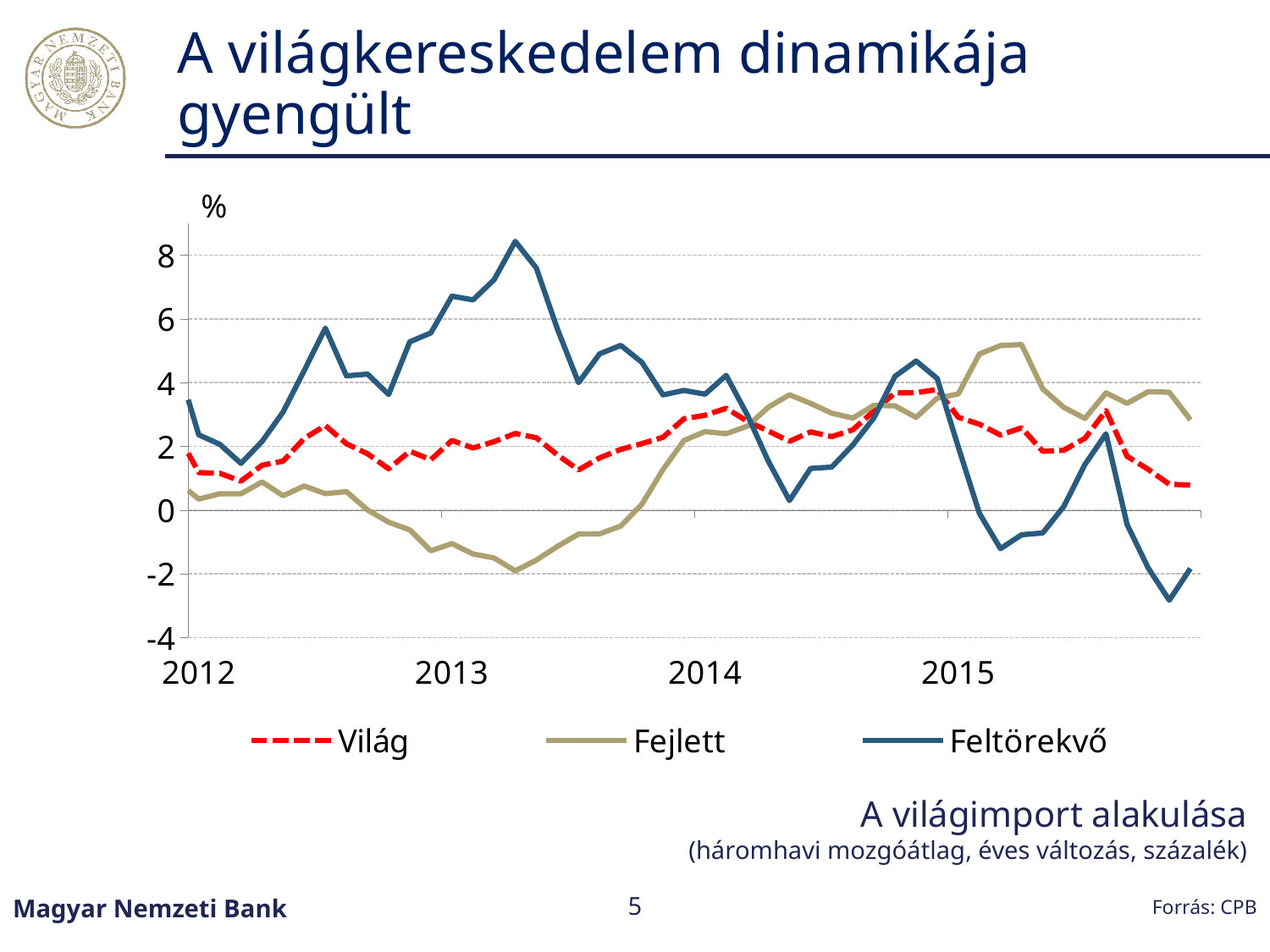
Is the final value of Feltörekvő at the right end of the chart greater or less than 0? less Is the peak value of Feltörekvő in 2013 greater or less than 6? greater How many years are labelled on the x axis? 4 Does the Világ series rise or fall from the start of 2015 to the right end of the chart? fall Is the lowest value of Fejlett in 2013 greater or less than 0? less Which series is drawn as a dashed red line? Világ What source is cited for the chart? CPB Which series reaches the lowest value anywhere on the chart? Feltörekvő What kind of chart is shown on the slide? line chart Which series reaches the highest value anywhere on the chart? Feltörekvő How many series does the legend list? 3